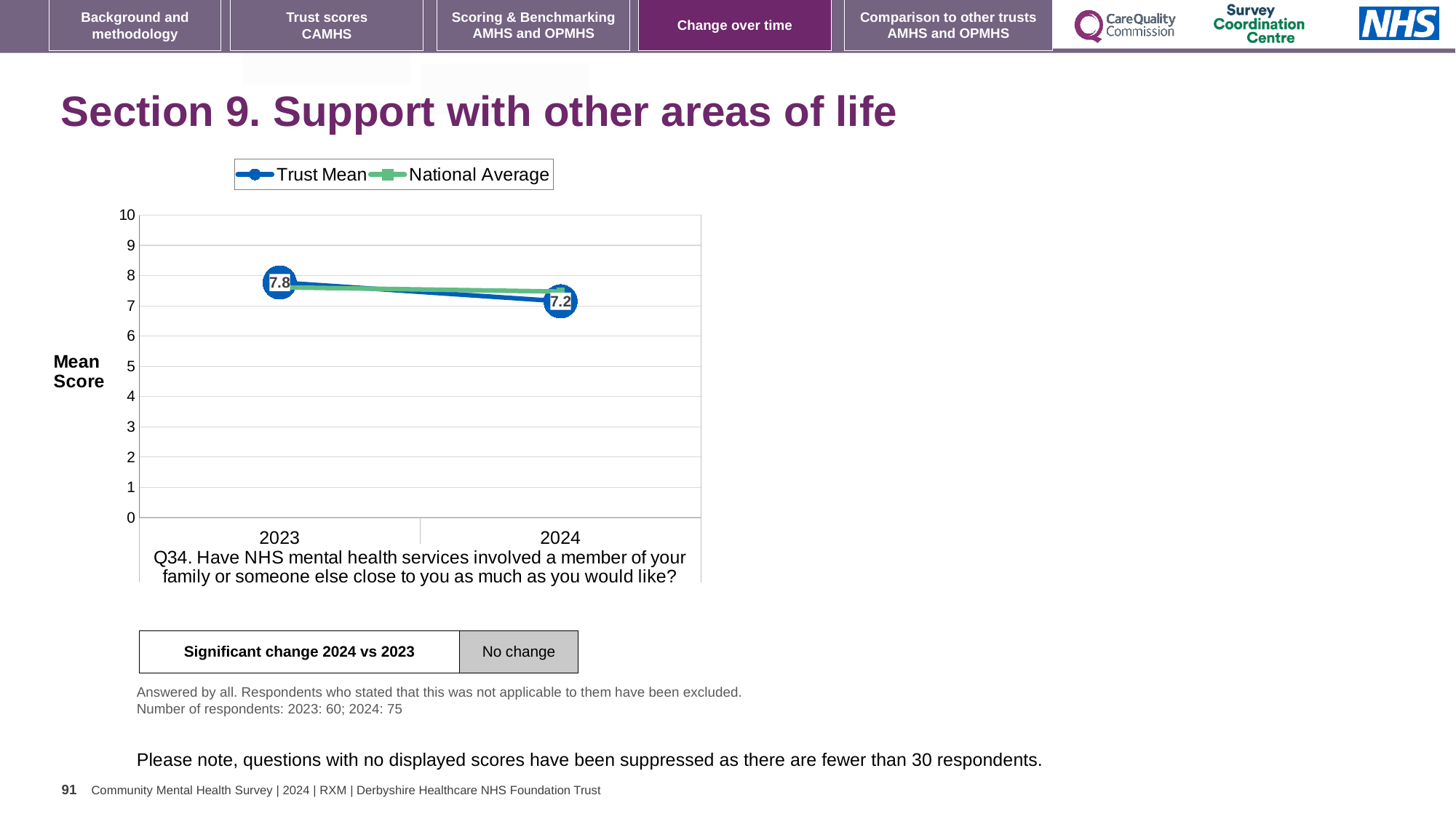
Which year has the higher Trust Mean score, 2023 or 2024? 2023 What is the Trust Mean score for 2024? 7.2 What kind of chart is shown on the slide? line chart Is the National Average value for 2023 greater or less than 5? greater What is the Trust Mean score for 2023? 7.8 By how much did the Trust Mean score change between 2023 and 2024? 0.6 How many series does the legend list? 2 In 2024, which is higher: the Trust Mean or the National Average? National Average Is the Trust Mean value for 2024 greater or less than 8? less What are the two series named in the legend? Trust Mean and National Average How many years are plotted on the x axis? 2 Does the Trust Mean rise or fall from 2023 to 2024? fall